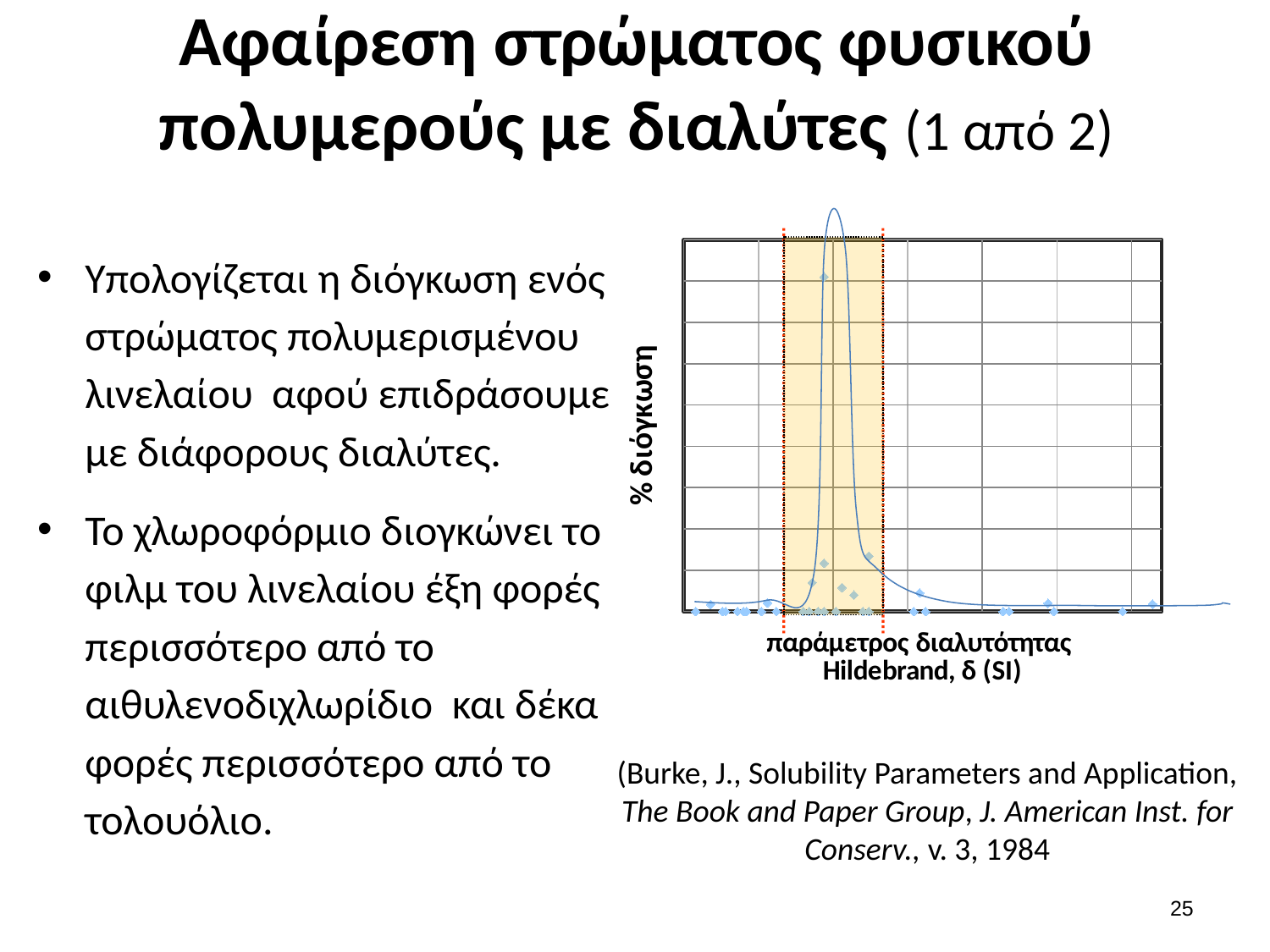
What is the title of the horizontal axis of the chart? παράμετρος διαλυτότητας Hildebrand, δ (SI) What kind of chart is shown on the slide? scatter chart with a fitted curve What is the title of the vertical axis of the chart? % διόγκωση Moving from left to right along the x axis, does the curve rise or fall immediately after its peak? fall Does the curve reach its peak inside or outside the shaded region between the dotted red lines? inside Moving from left to right along the x axis, does the curve rise or fall immediately before reaching its peak? rise